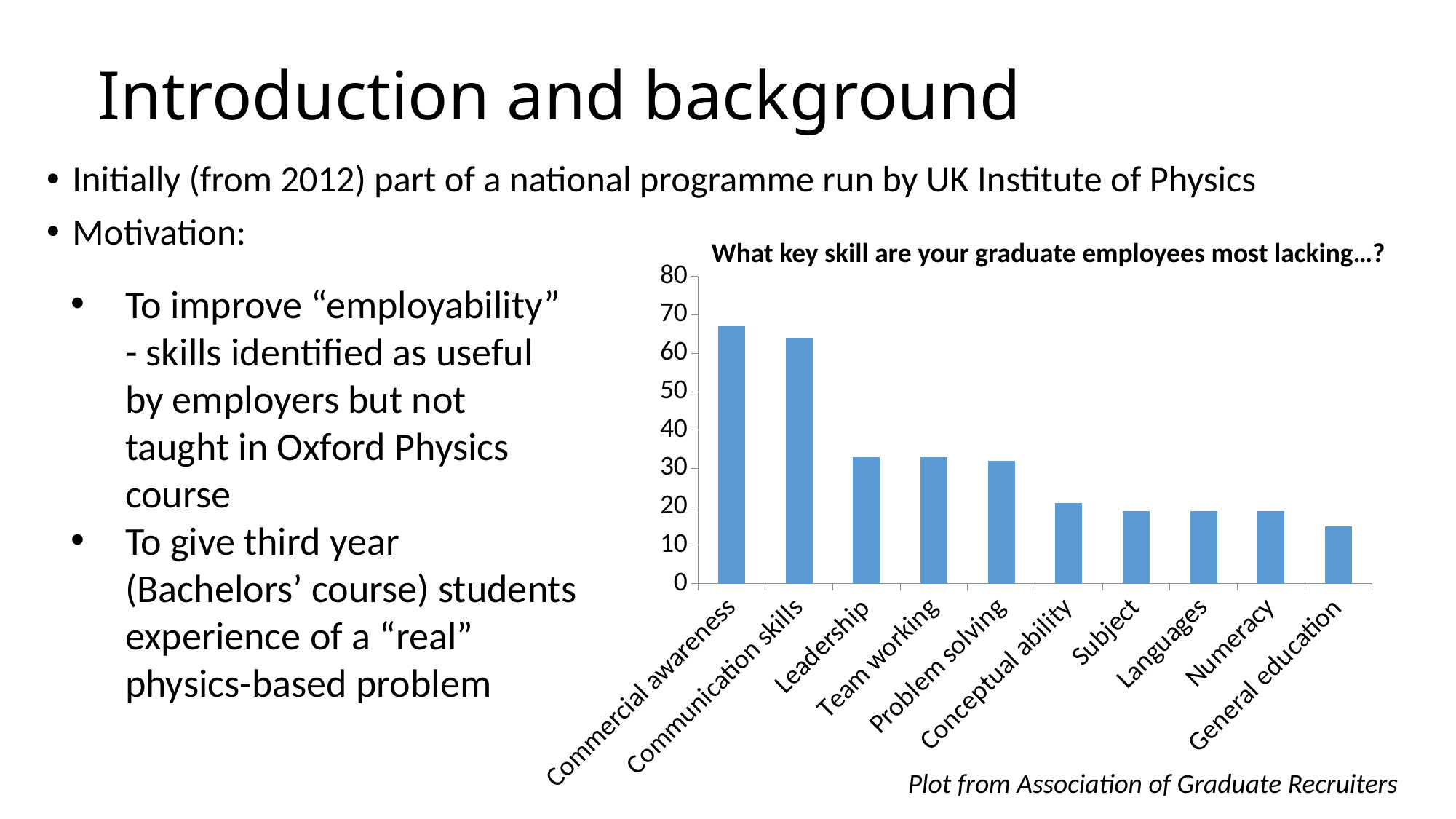
What kind of chart is shown on the slide? bar chart Is the value for Communication skills greater or less than 60? greater Do the bar values generally rise or fall from left to right along the x axis? fall Is the value for Conceptual ability greater or less than 30? less Which is larger, the value for Leadership or the value for Conceptual ability? Leadership How many skill categories are shown on the x axis of the chart? 10 What is the title of the chart? What key skill are your graduate employees most lacking…? Which skill has the lowest bar in the chart? General education Is the value for Commercial awareness greater or less than 60? greater According to the caption, where is the plot from? Association of Graduate Recruiters Which skill has the highest bar in the chart? Commercial awareness